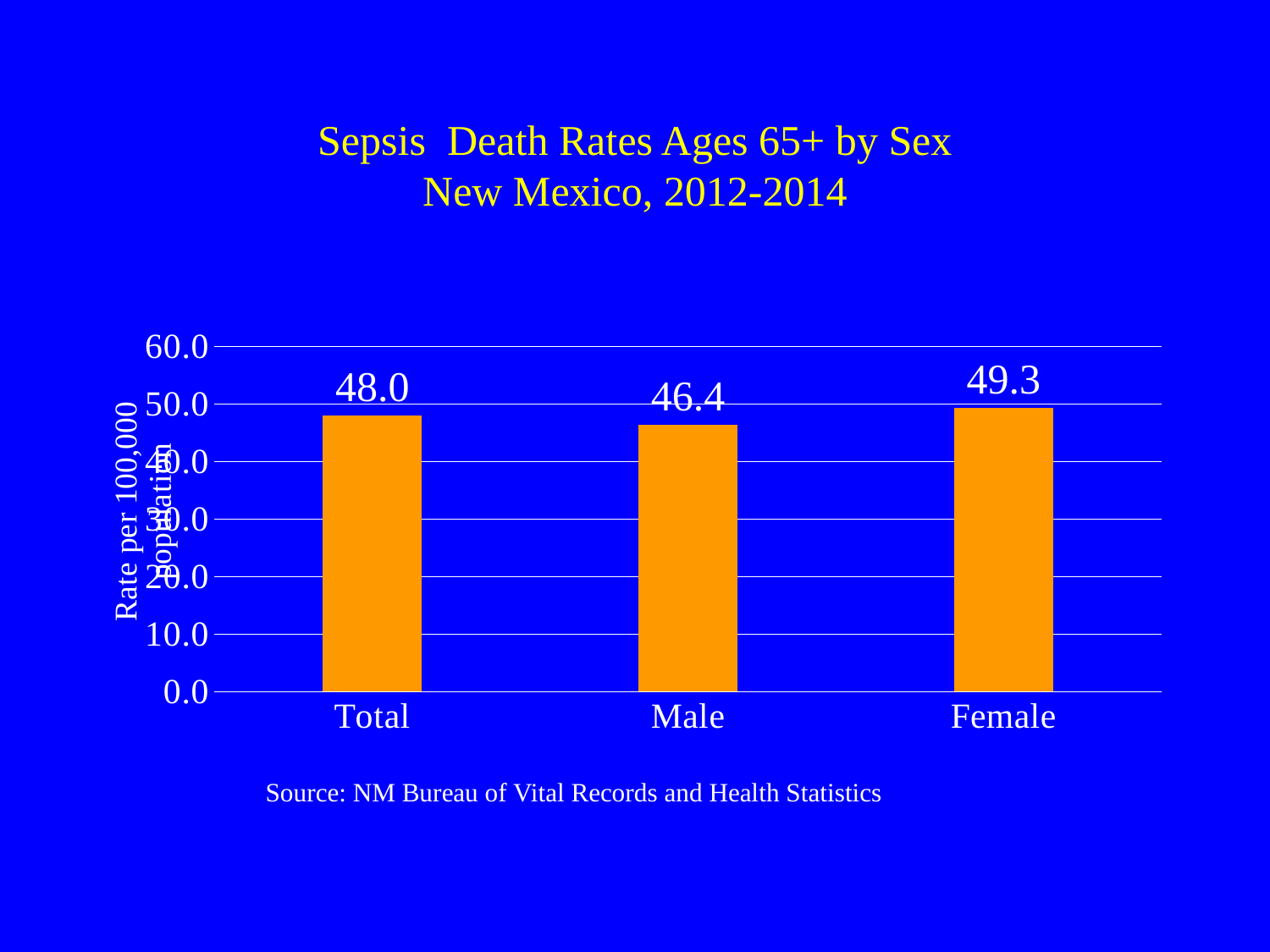
Which category has the lowest sepsis death rate? Male What is the difference between the Female and Total sepsis death rates? 1.3 Is the value for Male greater or less than 50.0? less What is the title of the chart? Sepsis Death Rates Ages 65+ by Sex New Mexico, 2012-2014 What kind of chart is shown on the slide? bar chart Which is larger, the sepsis death rate for Male or for Female? Female Which category has the highest sepsis death rate? Female What is the difference between the Female and Male sepsis death rates? 2.9 What is the sepsis death rate for Total? 48.0 What is the sepsis death rate for Female? 49.3 How many categories are shown on the x axis? 3 What is the sepsis death rate for Male? 46.4